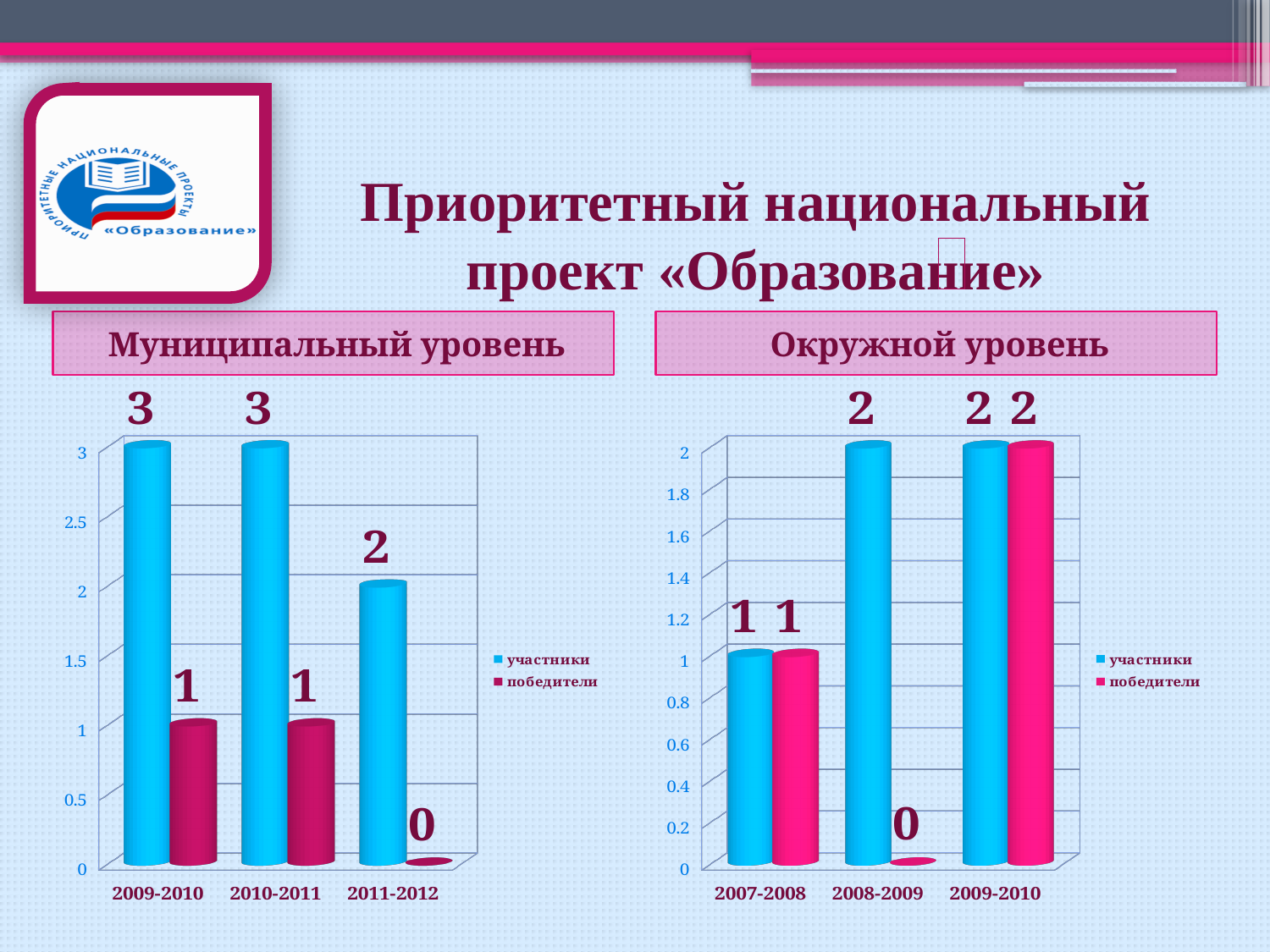
What kind of chart is the 'Муниципальный уровень' chart? bar chart In the 'Окружной уровень' chart, which is larger in 2008-2009: участники or победители? участники In the 'Муниципальный уровень' chart, what is the difference between участники and победители in 2010-2011? 2 In the 'Окружной уровень' chart, what is the value for победители in 2009-2010? 2 In the 'Окружной уровень' chart, what is the value for участники in 2008-2009? 2 In the 'Окружной уровень' chart, which category has the lowest value for победители? 2008-2009 In the 'Муниципальный уровень' chart, what is the value for участники in 2009-2010? 3 How many categories are shown on the x axis of the 'Окружной уровень' chart? 3 In the 'Окружной уровень' chart, what is the total of участники across all three categories? 5 In the 'Муниципальный уровень' chart, what is the value for победители in 2011-2012? 0 In the 'Муниципальный уровень' chart, which category has the lowest value for участники? 2011-2012 How many series does the legend of the 'Муниципальный уровень' chart list? 2